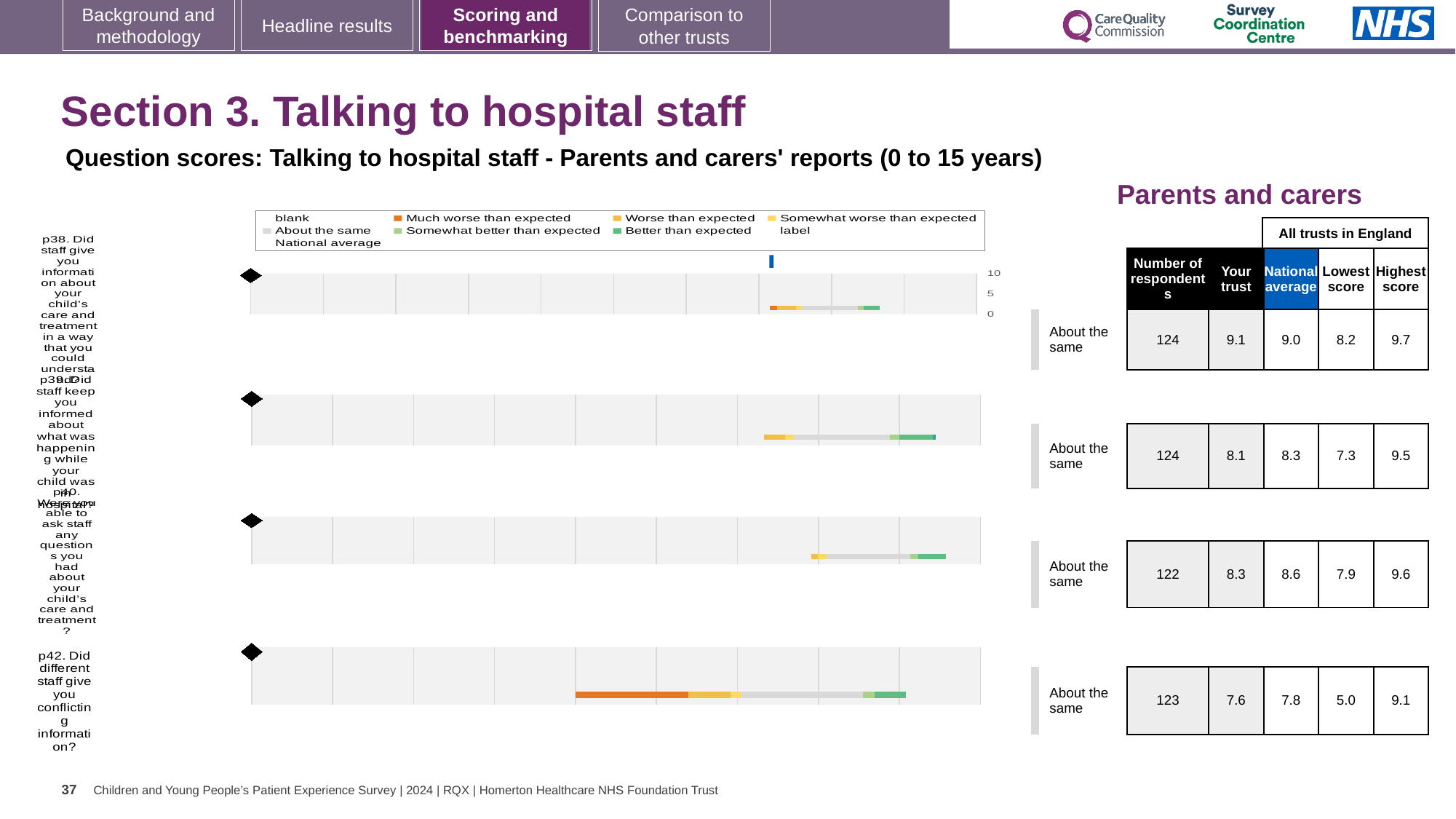
How many respondents answered p40 (Were you able to ask staff any questions you had about your child's care and treatment)? 122 What is the National average score for p39 (Did staff keep you informed about what was happening while your child was in hospital)? 8.3 What is the 'Your trust' score for p38 (Did staff give you information about your child's care and treatment in a way that you could understand)? 9.1 What is the difference between the Highest score and the Lowest score for p42? 4.1 For p38, which is larger: the 'Your trust' score or the National average? Your trust What kind of chart is used to show the question scores on this slide? bar chart What benchmark category is shown next to each of the four question bars? About the same How many questions (p38, p39, p40, p42) are plotted as separate bars on the slide? 4 Which question has the highest 'Your trust' score on this slide? p38 What is the Highest score among all trusts in England for p40? 9.6 What is the Lowest score among all trusts in England for p42 (Did different staff give you conflicting information)? 5.0 Which question has the lowest 'Your trust' score on this slide? p42